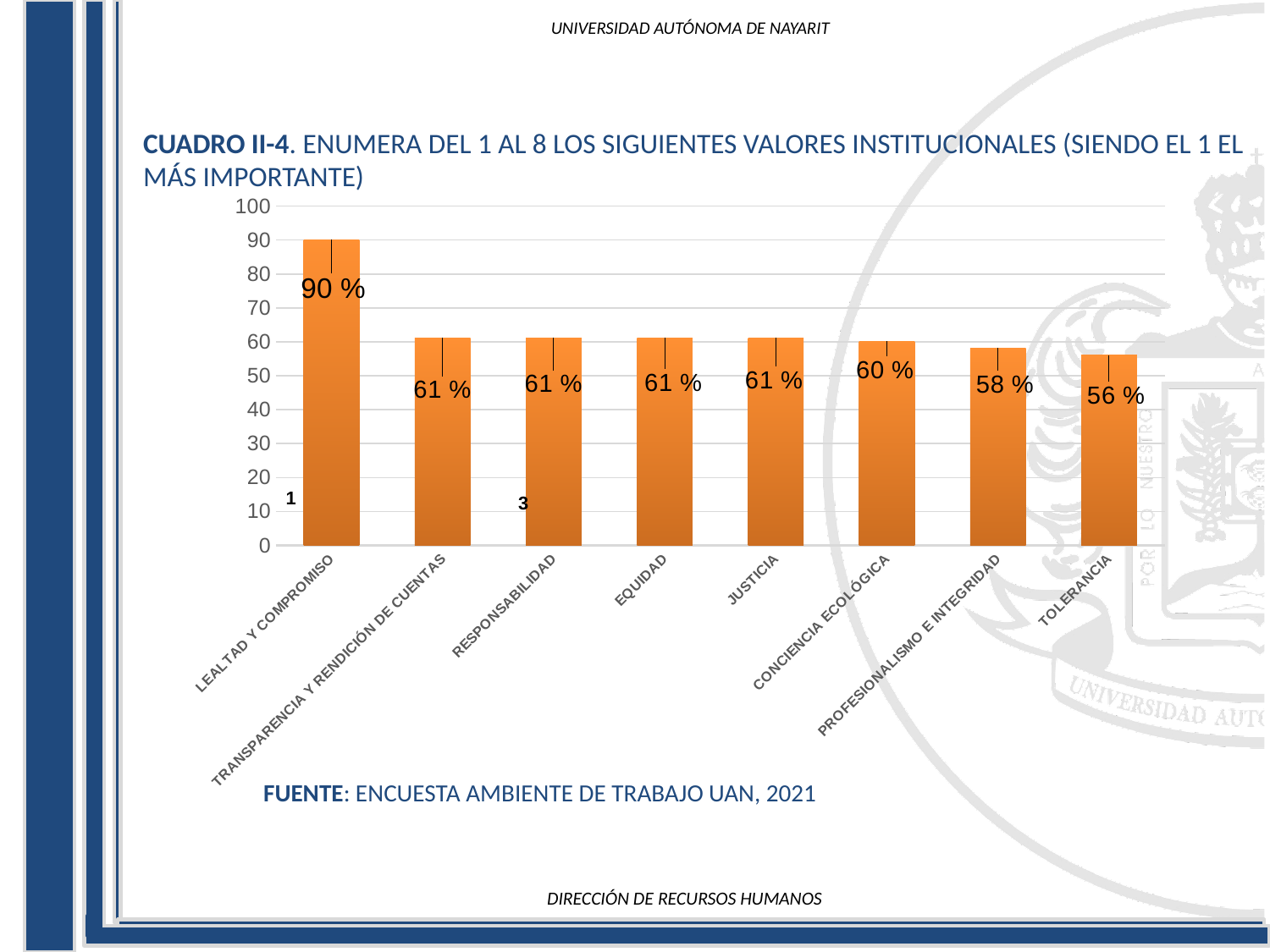
What kind of chart is shown on the slide? bar chart What is the value for TOLERANCIA? 56 % What is the value for LEALTAD Y COMPROMISO? 90 % How many categories are shown on the x axis? 8 Which category has the lowest value? TOLERANCIA What source is cited below the chart? ENCUESTA AMBIENTE DE TRABAJO UAN, 2021 What is the value for PROFESIONALISMO E INTEGRIDAD? 58 % Is the value for LEALTAD Y COMPROMISO greater or less than 80? greater Which is larger, the value for CONCIENCIA ECOLÓGICA or the value for TOLERANCIA? CONCIENCIA ECOLÓGICA What is the value for CONCIENCIA ECOLÓGICA? 60 % Which category has the highest value? LEALTAD Y COMPROMISO What is the difference between the values for LEALTAD Y COMPROMISO and TOLERANCIA? 34 %